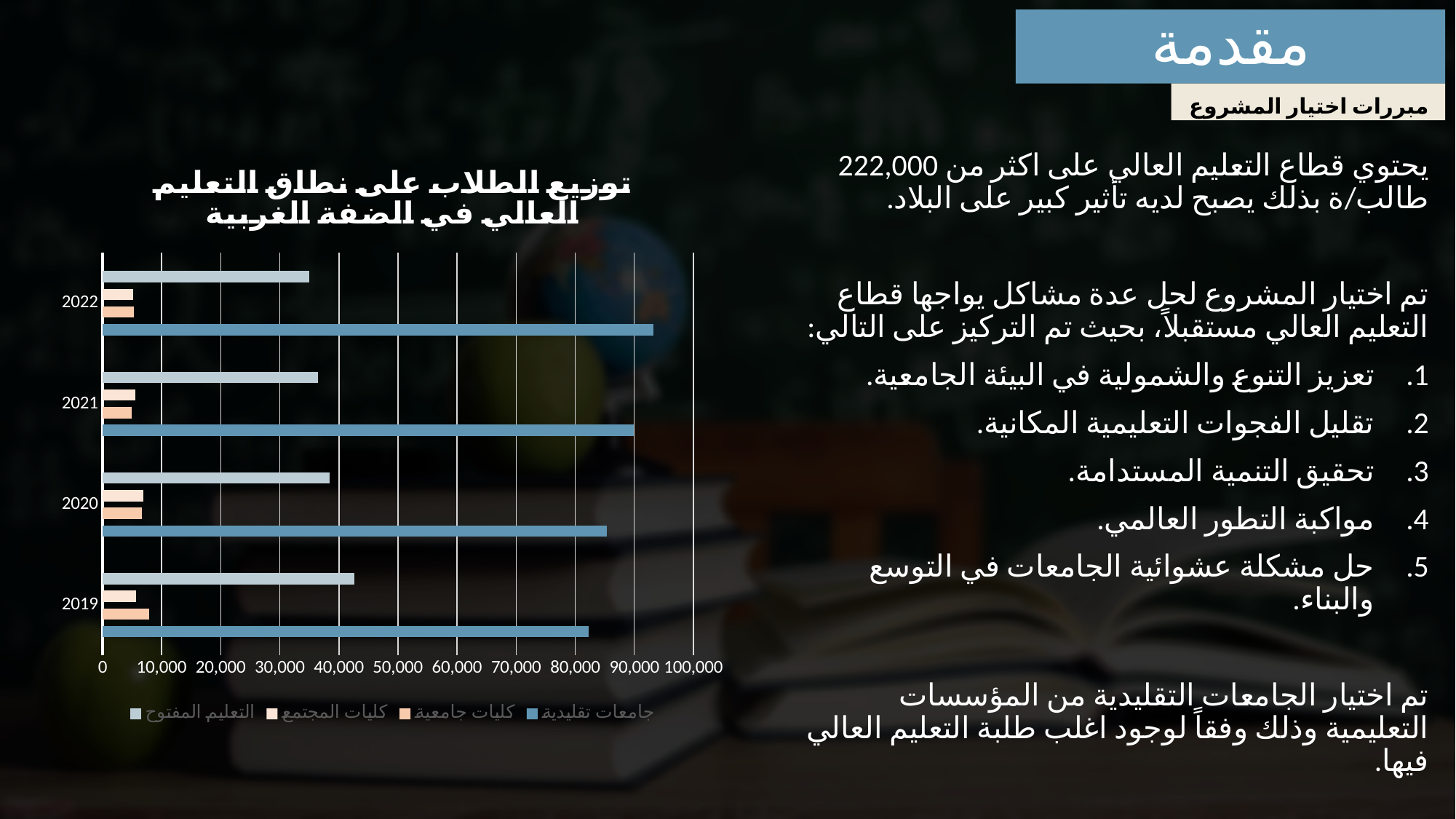
Which is larger in 2019: جامعات تقليدية or التعليم المفتوح? جامعات تقليدية How many years (categories) are shown on the chart? 4 What kind of chart is shown on the slide? bar chart Is the value for جامعات تقليدية in 2022 greater or less than 90,000? greater What is the title of the chart? توزيع الطلاب على نطاق التعليم العالي في الضفة الغربية Is the value for التعليم المفتوح in 2022 greater or less than 40,000? less Is the value for كليات المجتمع in 2019 greater or less than 10,000? less How many series does the chart legend list? 4 Which series has the highest value in 2022? جامعات تقليدية Does the value for التعليم المفتوح rise or fall from 2019 to 2022? fall